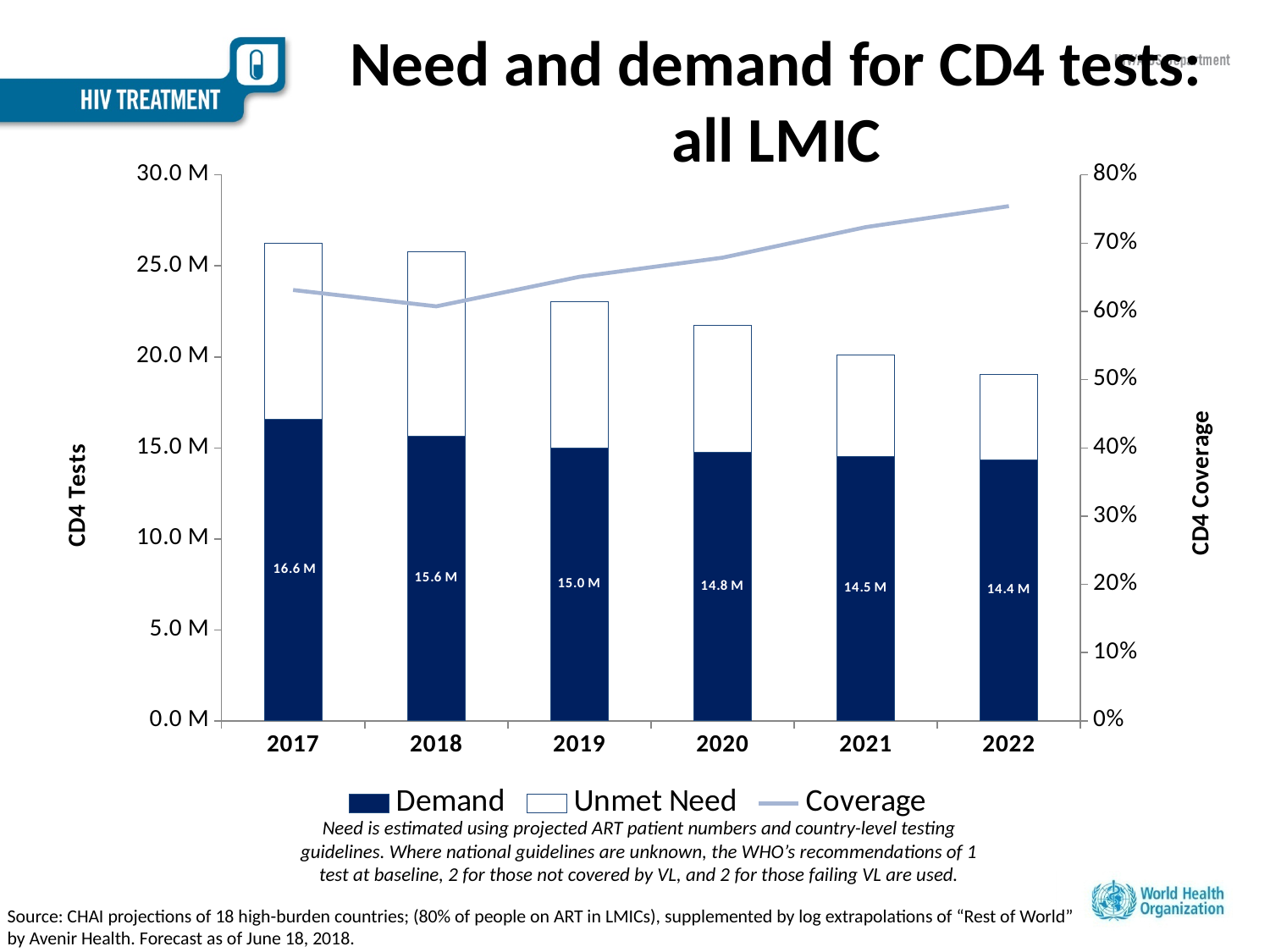
How many years are shown on the x axis? 6 How many series does the legend list? 3 Is the total height of the 2017 bar (Demand plus Unmet Need) greater or less than 25.0 M? greater What is the Demand value for 2020? 14.8 M What is the difference between the Demand in 2017 and the Demand in 2022? 2.2 M Which year has the lowest Demand? 2022 What is the Demand value for 2017? 16.6 M Which year has the highest Demand? 2017 Which is larger, the Demand in 2018 or the Demand in 2021? 2018 Does the Demand rise or fall from 2017 to 2022? fall Is the Coverage value for 2022 greater or less than 70%? greater What is the Demand value for 2022? 14.4 M